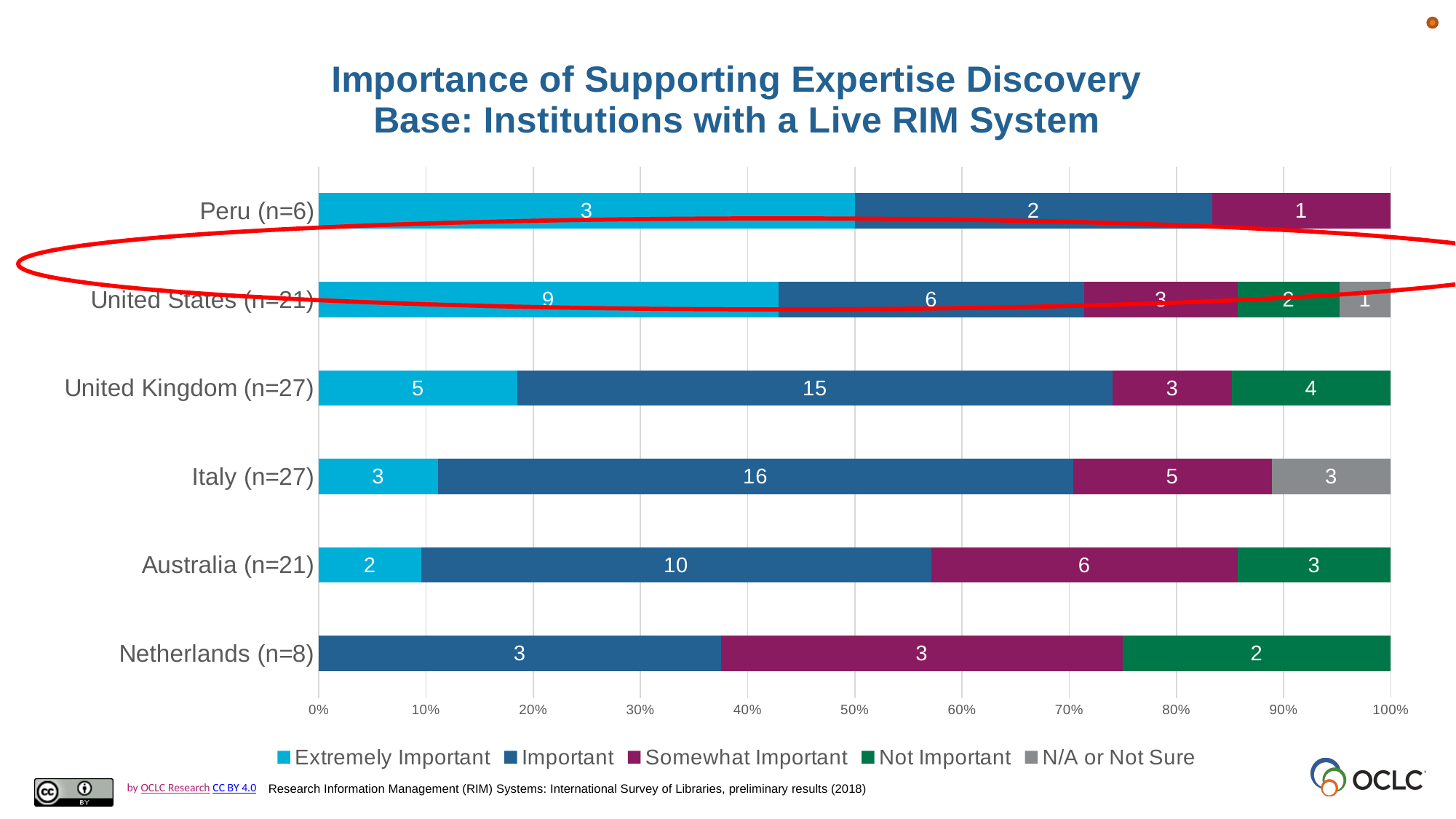
What is the first entry in the chart legend? Extremely Important How many countries are shown on the chart? 6 Which has the larger Somewhat Important count, Australia (n=21) or Italy (n=27)? Australia (n=21) What kind of chart is shown on the slide? Stacked bar chart What is the Not Important value for United Kingdom (n=27)? 4 Which country has the highest Important count? Italy (n=27) What is the Extremely Important value for United States (n=21)? 9 What is the N/A or Not Sure value for Italy (n=27)? 3 How many series does the legend list? 5 For United Kingdom (n=27), what is the difference between the Important and Extremely Important counts? 10 What is the total of the data labels in the Peru (n=6) bar? 6 How many institutions in Italy (n=27) rated supporting expertise discovery as Important? 16